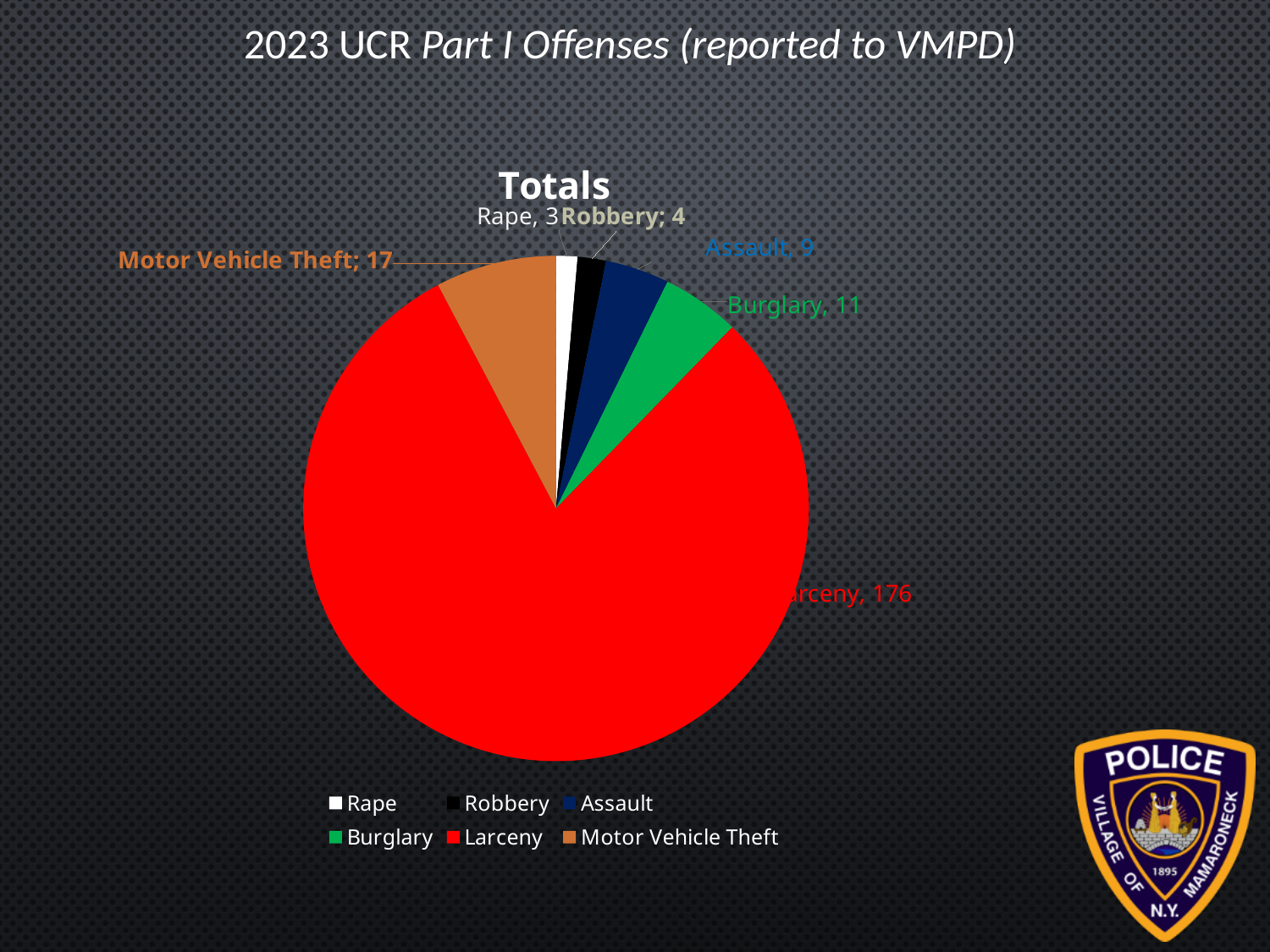
Which category has the smallest slice of the pie chart? Rape What is the value for Burglary in the pie chart? 11 How many categories are shown in the pie chart? 6 What is the value for Motor Vehicle Theft in the pie chart? 17 What share of the pie does Larceny represent? 80% What kind of chart is shown on the slide? Pie chart Which category has the largest slice of the pie chart? Larceny What is the value for Larceny in the pie chart? 176 What is the difference between the values for Motor Vehicle Theft and Burglary? 6 What is the value for Assault in the pie chart? 9 What is the title of the pie chart? Totals Which is larger, the value for Robbery or the value for Assault? Assault